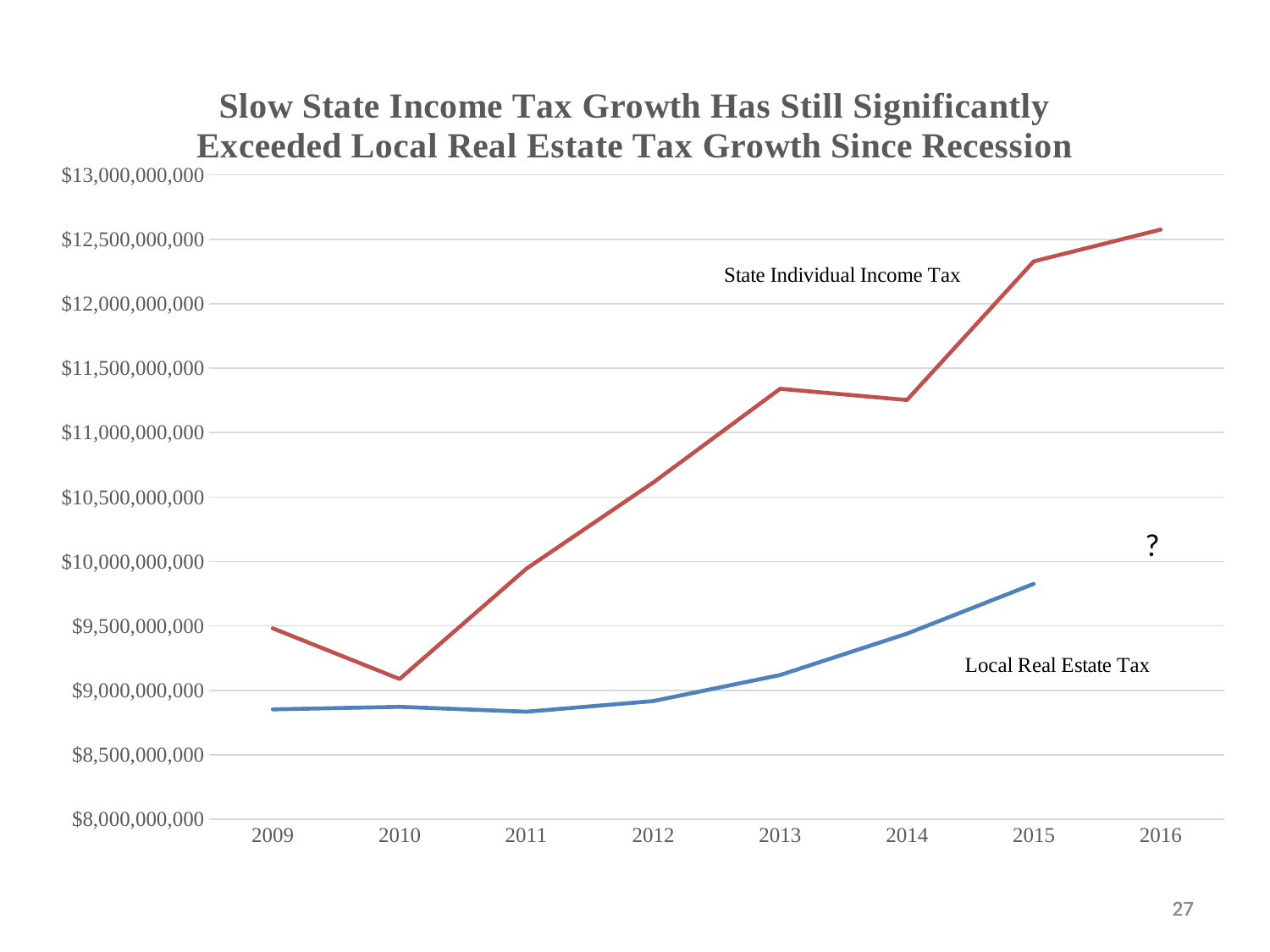
How many years are shown on the x axis of the chart? 8 Is the value for State Individual Income Tax in 2016 greater or less than $12,000,000,000? greater Is the value for State Individual Income Tax in 2010 greater or less than $9,500,000,000? less Is the value for Local Real Estate Tax in 2009 greater or less than $9,000,000,000? less Does Local Real Estate Tax rise or fall from 2012 to 2015? Rise In 2013, which is larger: State Individual Income Tax or Local Real Estate Tax? State Individual Income Tax In which year is Local Real Estate Tax at its highest? 2015 How many data series are plotted on the chart? 2 In which year is State Individual Income Tax at its highest? 2016 In which year is State Individual Income Tax at its lowest? 2010 What kind of chart is shown on the slide? Line chart